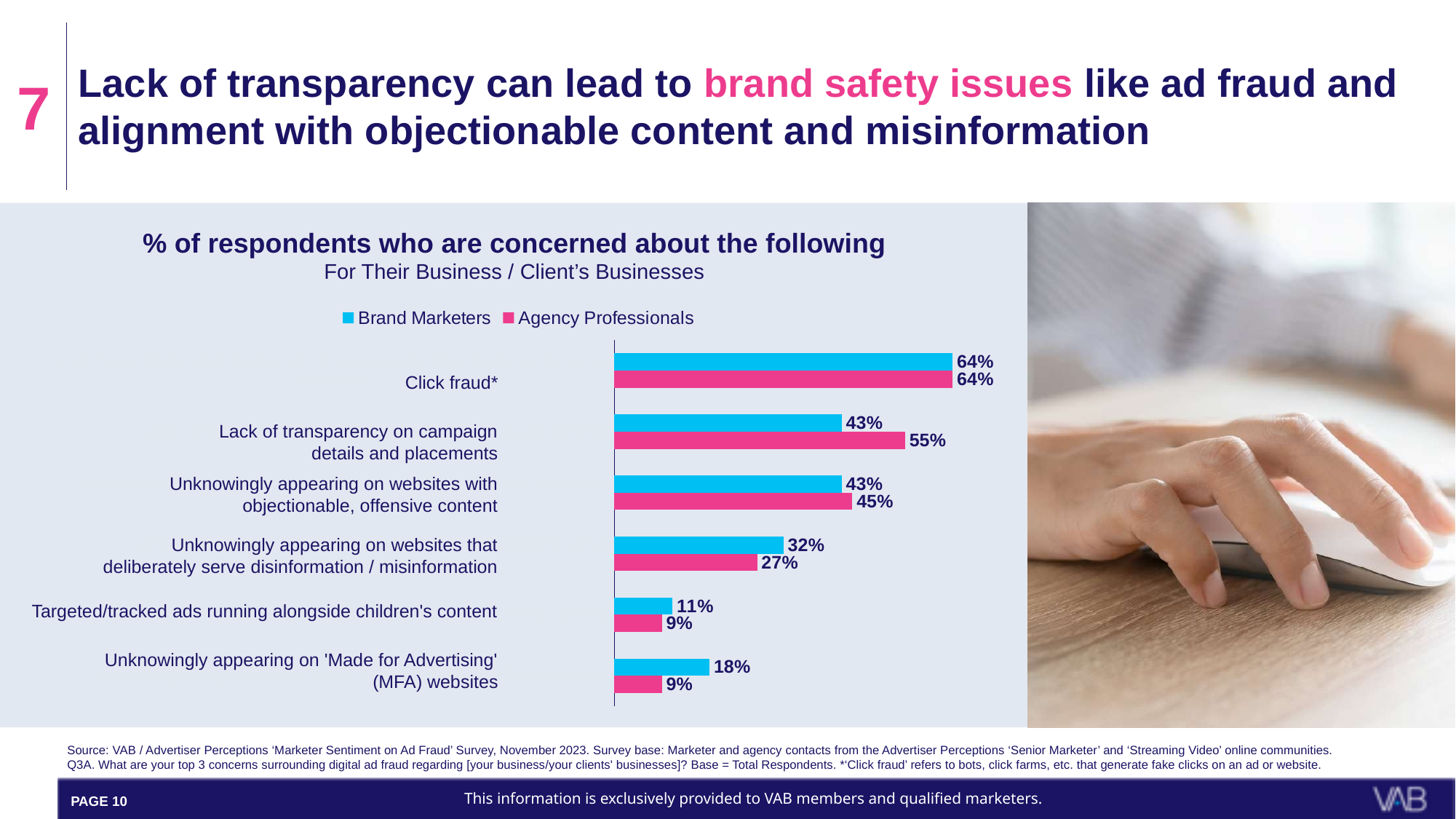
What percentage of Brand Marketers are concerned about click fraud? 64% What percentage of Agency Professionals are concerned about lack of transparency on campaign details and placements? 55% For unknowingly appearing on websites that deliberately serve disinformation / misinformation, which group has the larger percentage, Brand Marketers or Agency Professionals? Brand Marketers Which colour represents Agency Professionals in the chart? Pink What is the difference between Agency Professionals and Brand Marketers for lack of transparency on campaign details and placements? 12 percentage points Which concern has the highest percentage among Agency Professionals? Click fraud* Which concern has the lowest percentage among Brand Marketers? Targeted/tracked ads running alongside children's content What percentage of Brand Marketers are concerned about unknowingly appearing on 'Made for Advertising' (MFA) websites? 18% What percentage of Agency Professionals are concerned about targeted/tracked ads running alongside children's content? 9% What type of chart is shown on the slide? Bar chart How many concern categories are shown in the chart? 6 How many series does the chart legend list? 2